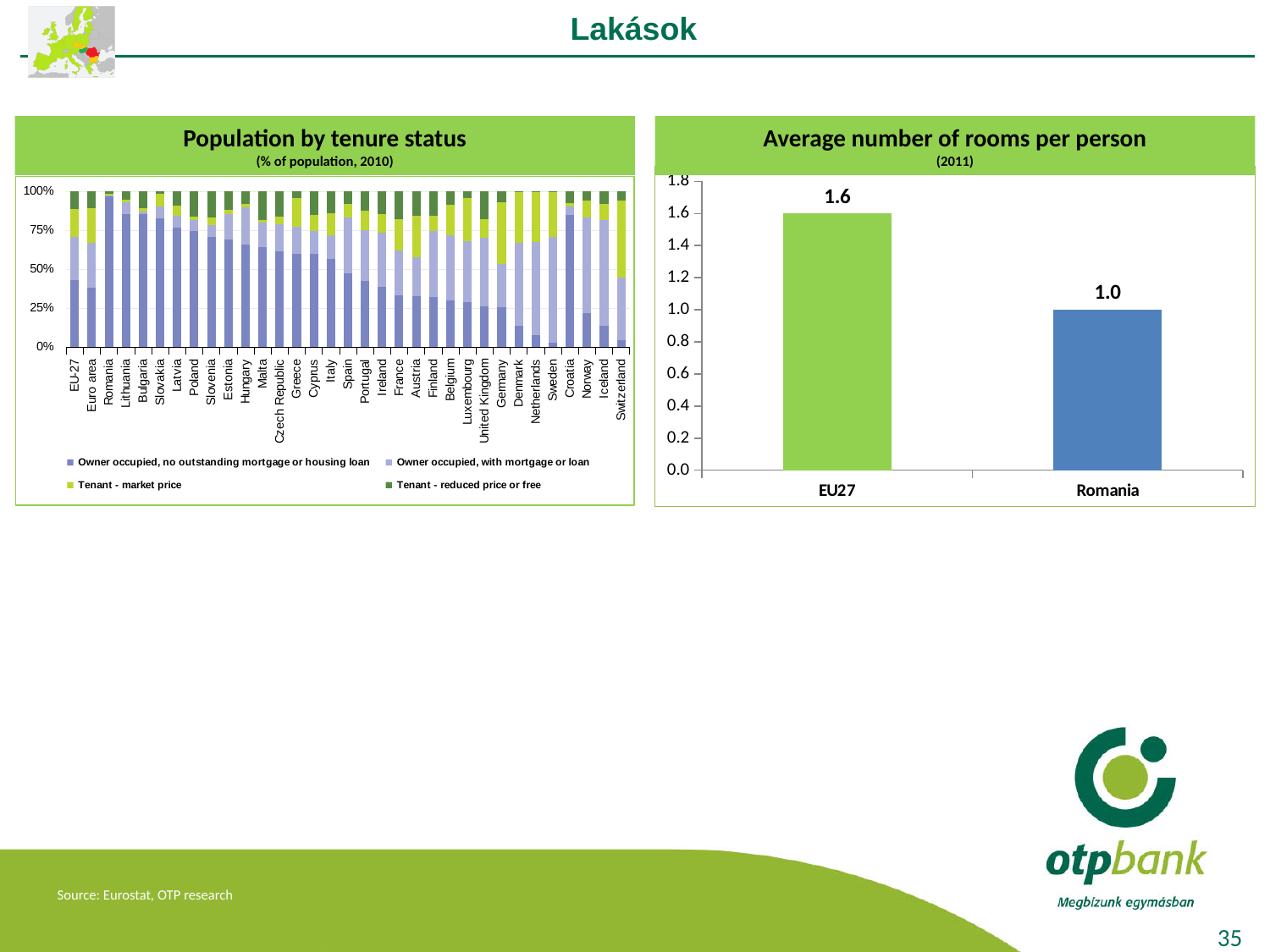
In the 'Population by tenure status' chart, how many series does the legend list? 4 In the 'Average number of rooms per person' chart, what is the value for EU27? 1.6 In the 'Average number of rooms per person' chart, which has the higher value, EU27 or Romania? EU27 In the 'Average number of rooms per person' chart, how many categories are shown? 2 In the 'Average number of rooms per person' chart, which year does the subtitle refer to? 2011 In the 'Population by tenure status' chart, how many countries or regions are shown on the x axis? 33 In the 'Population by tenure status' chart, is the 'Owner occupied, no outstanding mortgage or housing loan' share for Switzerland greater or less than 25%? less In the 'Average number of rooms per person' chart, what is the value for Romania? 1.0 What kind of chart is the 'Average number of rooms per person' chart? Bar chart In the 'Population by tenure status' chart, is the 'Owner occupied, no outstanding mortgage or housing loan' share for Romania greater or less than 75%? greater In the 'Average number of rooms per person' chart, what is the difference between the EU27 and Romania values? 0.6 What kind of chart is the 'Population by tenure status' chart? Stacked bar chart